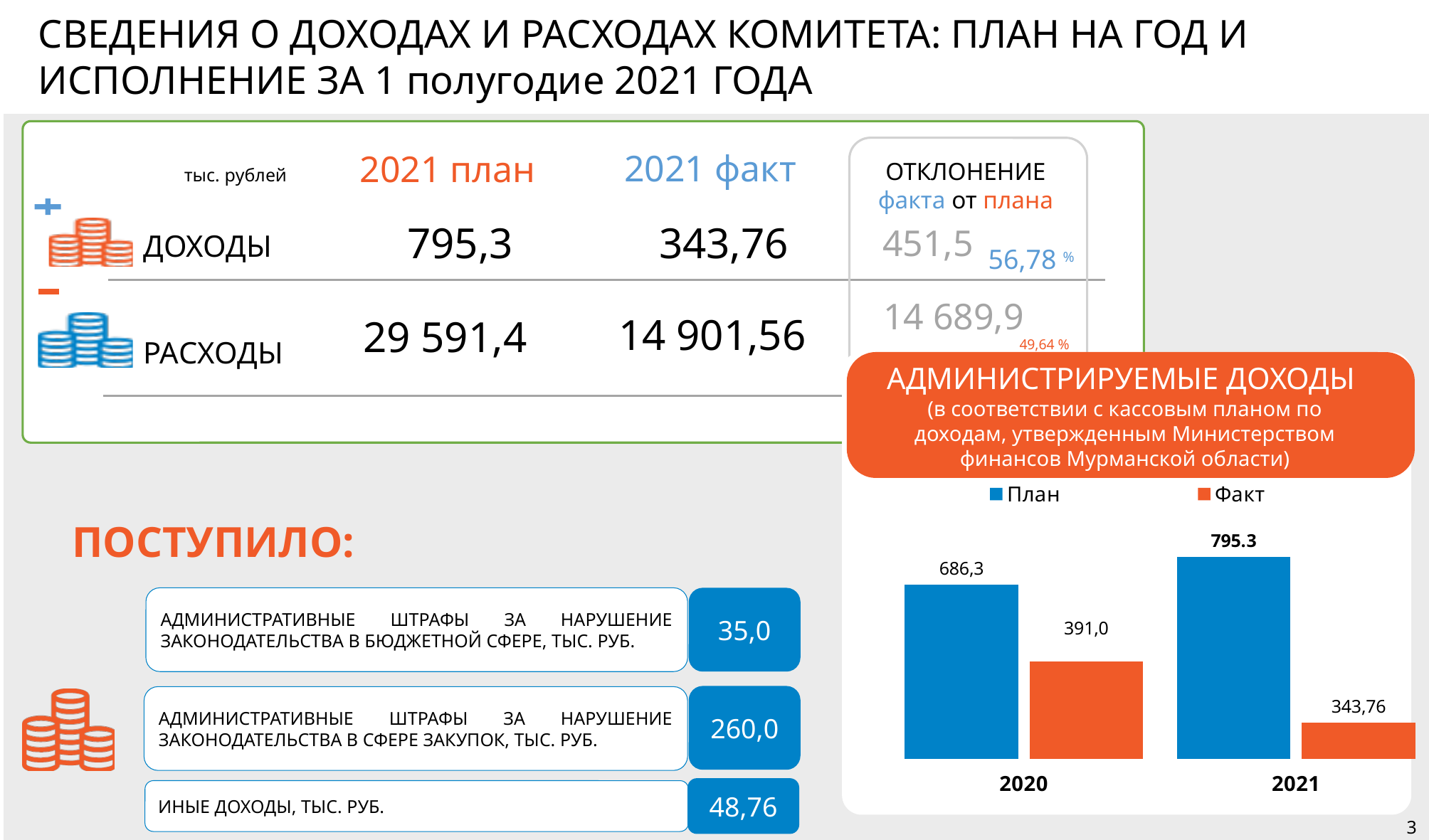
In the АДМИНИСТРИРУЕМЫЕ ДОХОДЫ chart, by how much does the Факт value for 2020 exceed the Факт value for 2021? 47,24 In the АДМИНИСТРИРУЕМЫЕ ДОХОДЫ chart, what is the Факт value for 2020? 391,0 In the АДМИНИСТРИРУЕМЫЕ ДОХОДЫ chart, what is the План value for 2020? 686,3 In the АДМИНИСТРИРУЕМЫЕ ДОХОДЫ chart, is the Факт value for 2020 larger or smaller than the Факт value for 2021? Larger In the АДМИНИСТРИРУЕМЫЕ ДОХОДЫ chart, does the Факт series rise or fall from 2020 to 2021? Fall In the АДМИНИСТРИРУЕМЫЕ ДОХОДЫ chart, which year has the highest План value? 2021 In the АДМИНИСТРИРУЕМЫЕ ДОХОДЫ chart, what is the difference between the План and Факт values for 2020? 295,3 In the АДМИНИСТРИРУЕМЫЕ ДОХОДЫ chart, what is the План value for 2021? 795.3 In the АДМИНИСТРИРУЕМЫЕ ДОХОДЫ chart, what is the Факт value for 2021? 343,76 How many series does the legend of the АДМИНИСТРИРУЕМЫЕ ДОХОДЫ chart list? 2 In the АДМИНИСТРИРУЕМЫЕ ДОХОДЫ chart, which year has the lowest Факт value? 2021 What type of chart is shown under the heading АДМИНИСТРИРУЕМЫЕ ДОХОДЫ? Bar chart